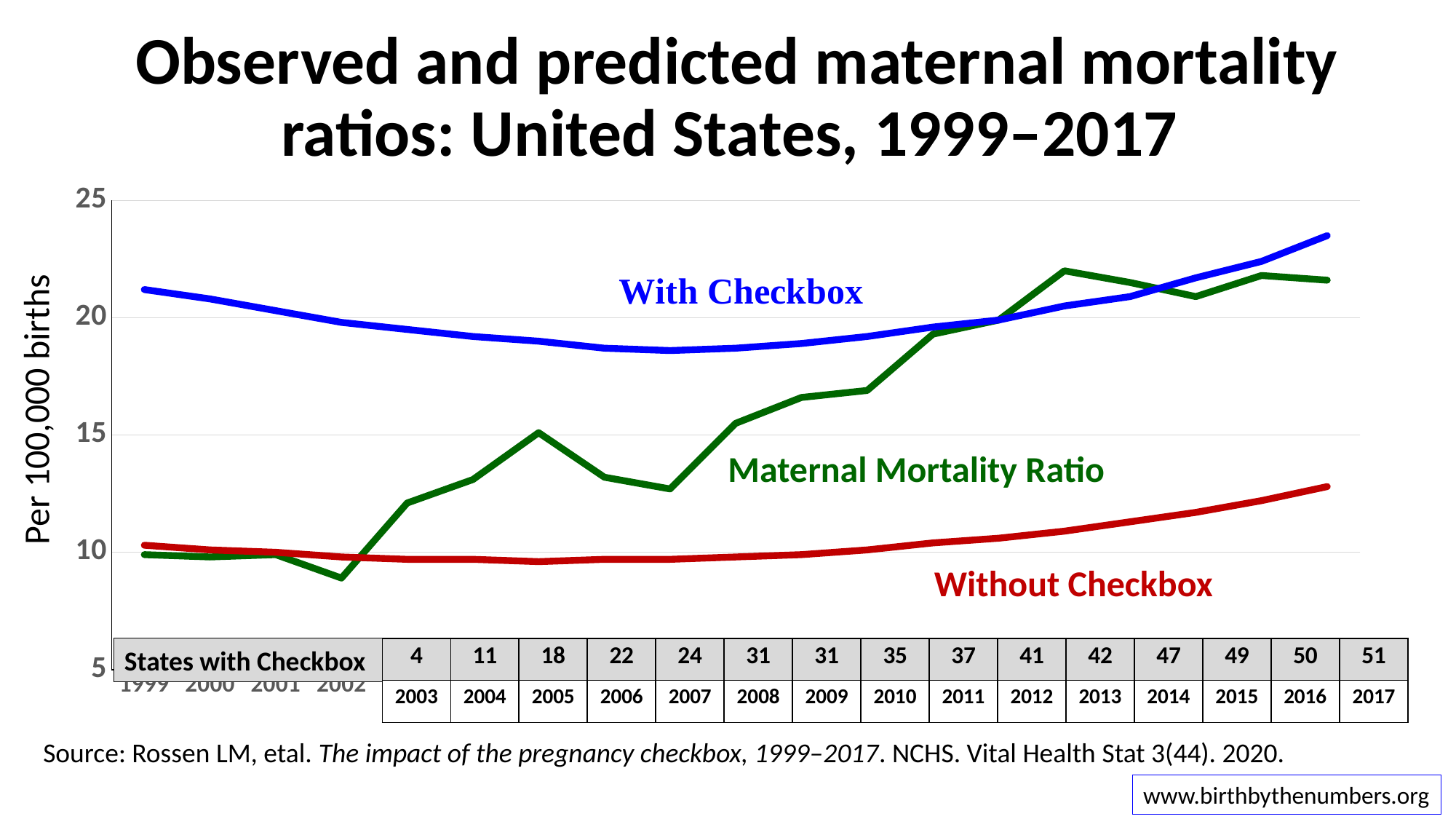
How many data series are plotted on the chart? 3 How many years are plotted along the x axis of the chart? 19 What kind of chart is shown on the slide? line chart In 2017, which is higher: With Checkbox or Maternal Mortality Ratio? With Checkbox Is the value for Without Checkbox in 2017 greater or less than 10? greater Is the value for Maternal Mortality Ratio in 2013 greater or less than 20? greater What is the label on the y axis of the chart? Per 100,000 births Is the value for Maternal Mortality Ratio in 2002 greater or less than 10? less Does the Without Checkbox line rise or fall from 2007 to 2017? rise In 2013, which is higher: Maternal Mortality Ratio or With Checkbox? Maternal Mortality Ratio